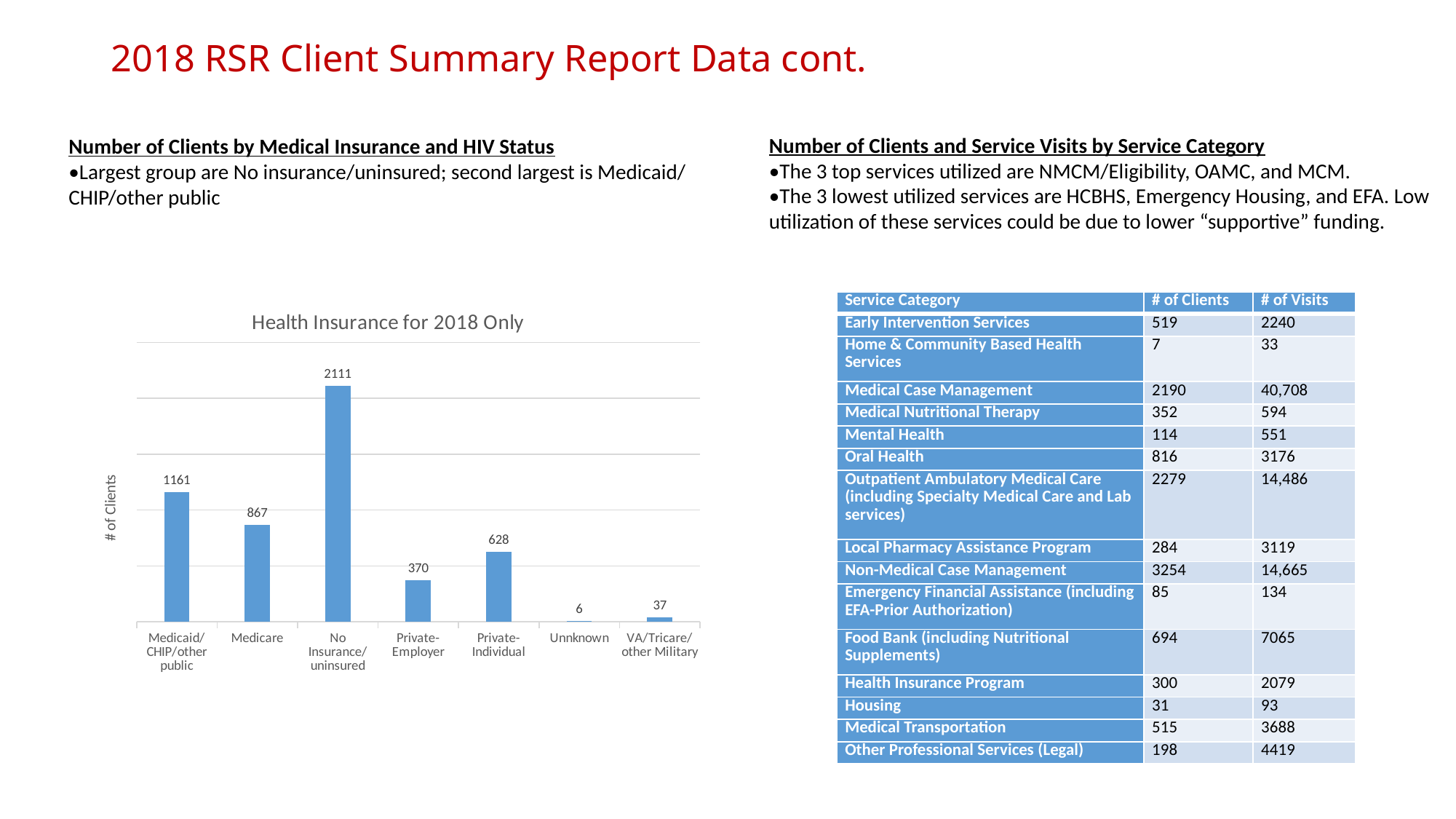
What is the difference between the values for Medicaid/CHIP/other public and Medicare in the Health Insurance for 2018 Only chart? 294 What is the value for Private-Individual in the Health Insurance for 2018 Only chart? 628 How many categories are shown in the Health Insurance for 2018 Only chart? 7 Which category has the highest value in the Health Insurance for 2018 Only chart? No Insurance/uninsured What is the value for No Insurance/uninsured in the Health Insurance for 2018 Only chart? 2111 What is the value for Medicare in the Health Insurance for 2018 Only chart? 867 Which is larger in the Health Insurance for 2018 Only chart, Medicare or Private-Individual? Medicare What is the difference between the values for Private-Individual and Private-Employer in the Health Insurance for 2018 Only chart? 258 Which category has the lowest value in the Health Insurance for 2018 Only chart? Unnknown What kind of chart is the Health Insurance for 2018 Only chart? Bar chart What is the y-axis label of the Health Insurance for 2018 Only chart? # of Clients What is the value for VA/Tricare/other Military in the Health Insurance for 2018 Only chart? 37